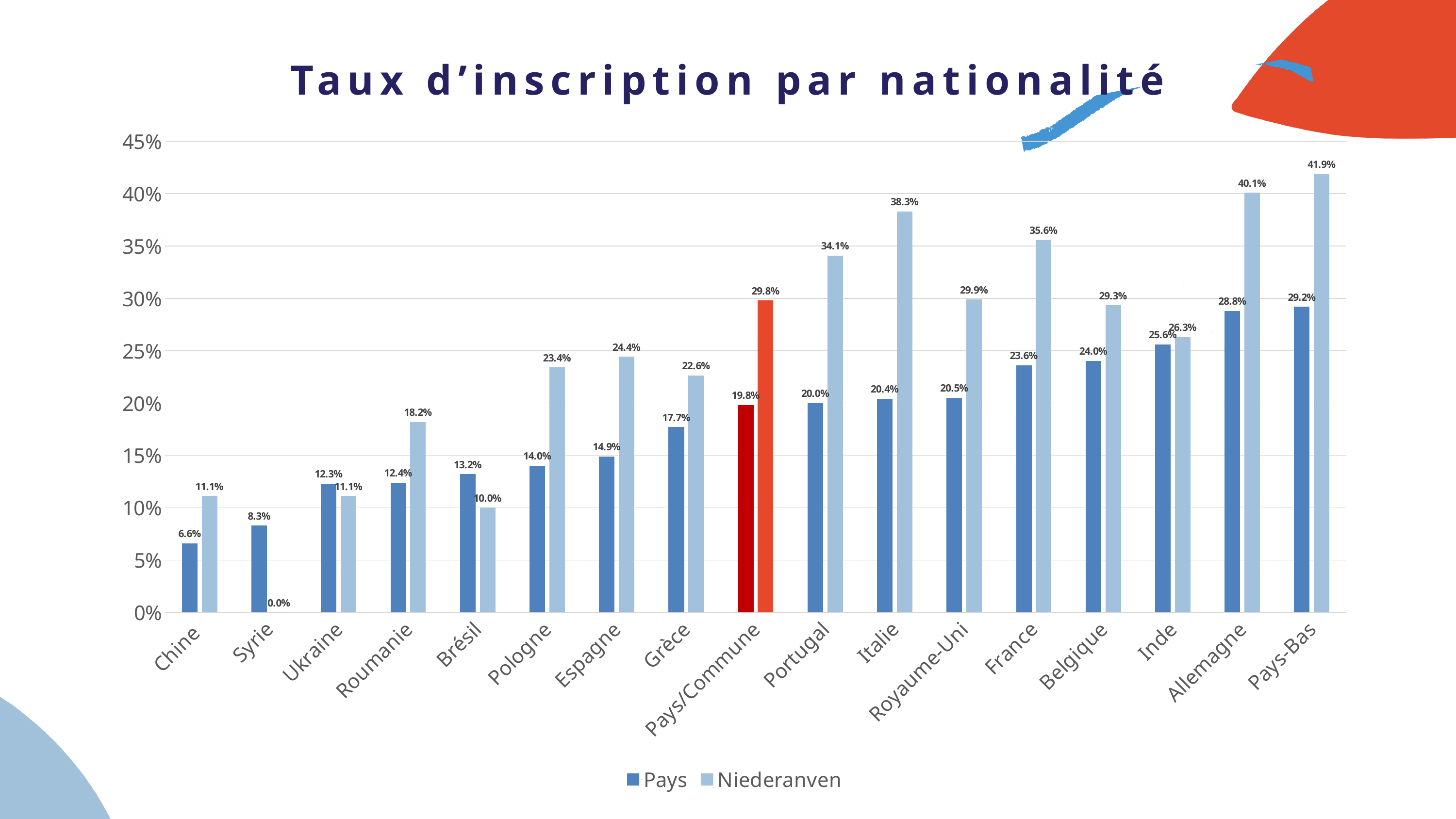
How many series does the legend list? 2 How many categories are shown on the x axis? 17 Is the Niederanven value for Allemagne greater or less than 35%? greater What kind of chart is shown on the slide? Bar chart Which category has the highest Niederanven value? Pays-Bas What is the Niederanven value for Pays-Bas? 41.9% Which category has the lowest Pays value? Chine What is the difference between the Niederanven and Pays values for Italie? 17.9% What is the Niederanven value for Syrie? 0.0% Which is larger for Brésil: the Pays value or the Niederanven value? Pays What is the title of the chart? Taux d'inscription par nationalité What is the Pays value for Grèce? 17.7%